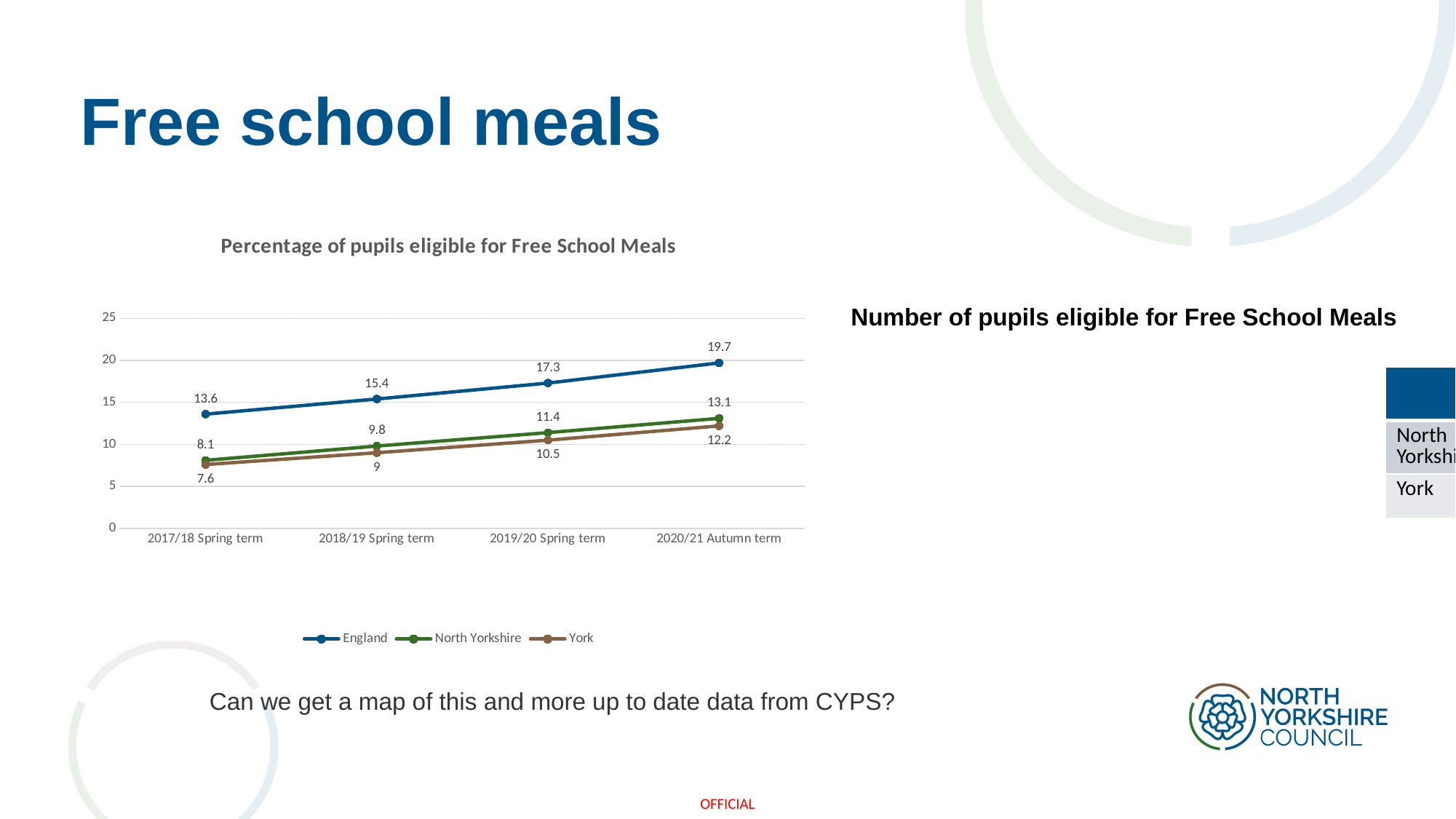
How many series does the legend list? 3 What type of chart is shown on the slide? Line chart What is the value for England in 2020/21 Autumn term? 19.7 Which is larger, the North Yorkshire value in 2019/20 Spring term or the York value in 2019/20 Spring term? North Yorkshire What is the value for North Yorkshire in 2017/18 Spring term? 8.1 What is the difference between the England and North Yorkshire values in 2020/21 Autumn term? 6.6 How many time periods are shown on the x axis? 4 What is the value for North Yorkshire in 2019/20 Spring term? 11.4 What is the value for York in 2018/19 Spring term? 9 Which series has the highest value in 2020/21 Autumn term? England Which series has the lowest value in 2017/18 Spring term? York Does the England series rise or fall from 2017/18 Spring term to 2020/21 Autumn term? Rise